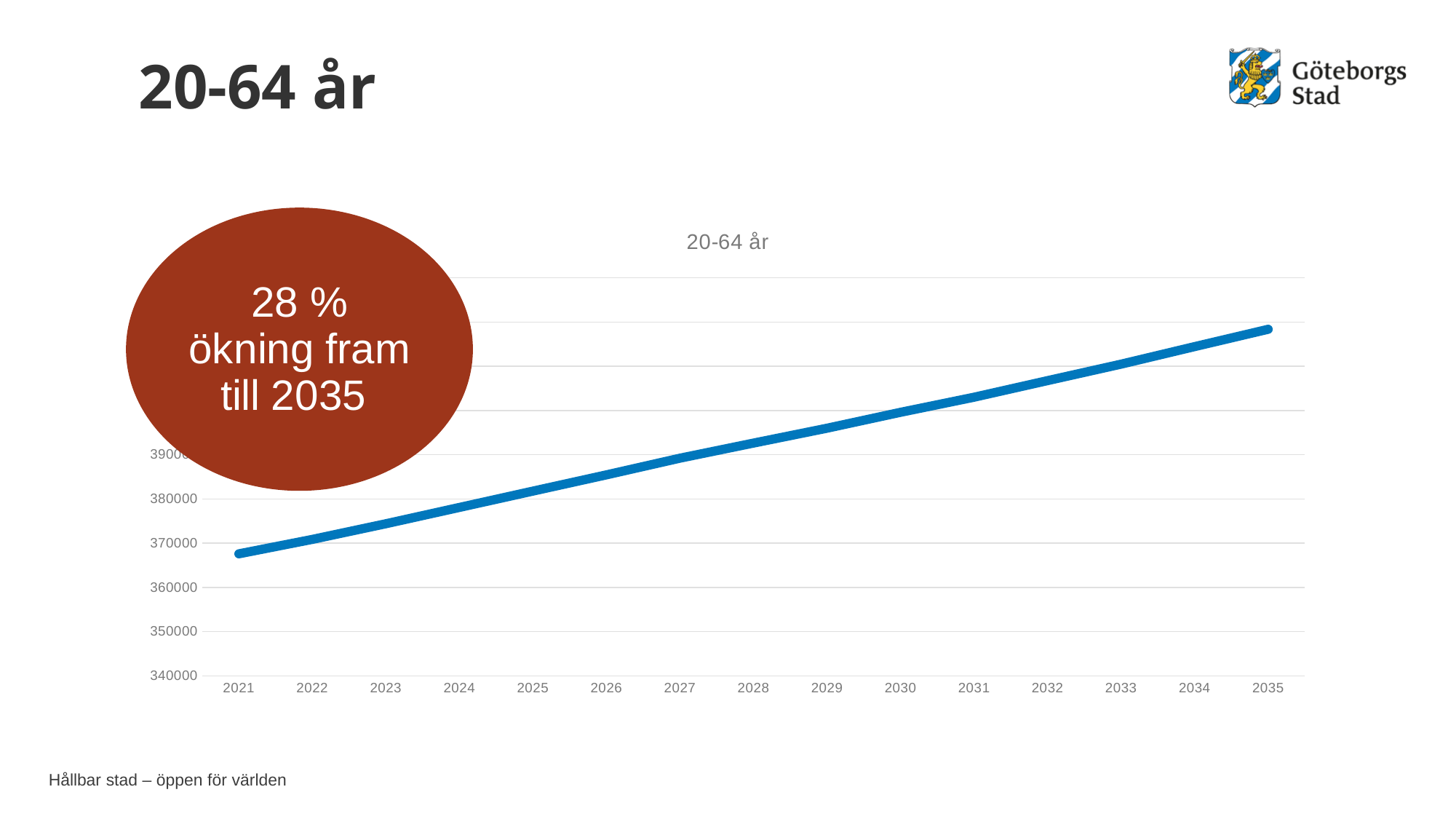
What is the title of the chart? 20-64 år How many years are shown on the x axis of the chart? 15 What kind of chart is shown on the slide? line chart Is the value for 2021 greater or less than 370000? less Which year has the larger value, 2023 or 2032? 2032 What percentage increase up to 2035 does the red circle on the slide state? 28 % Do the values rise or fall from 2021 to 2035? rise Is the value for 2035 greater or less than 390000? greater Which year has the highest value on the chart? 2035 Which year has the lowest value on the chart? 2021